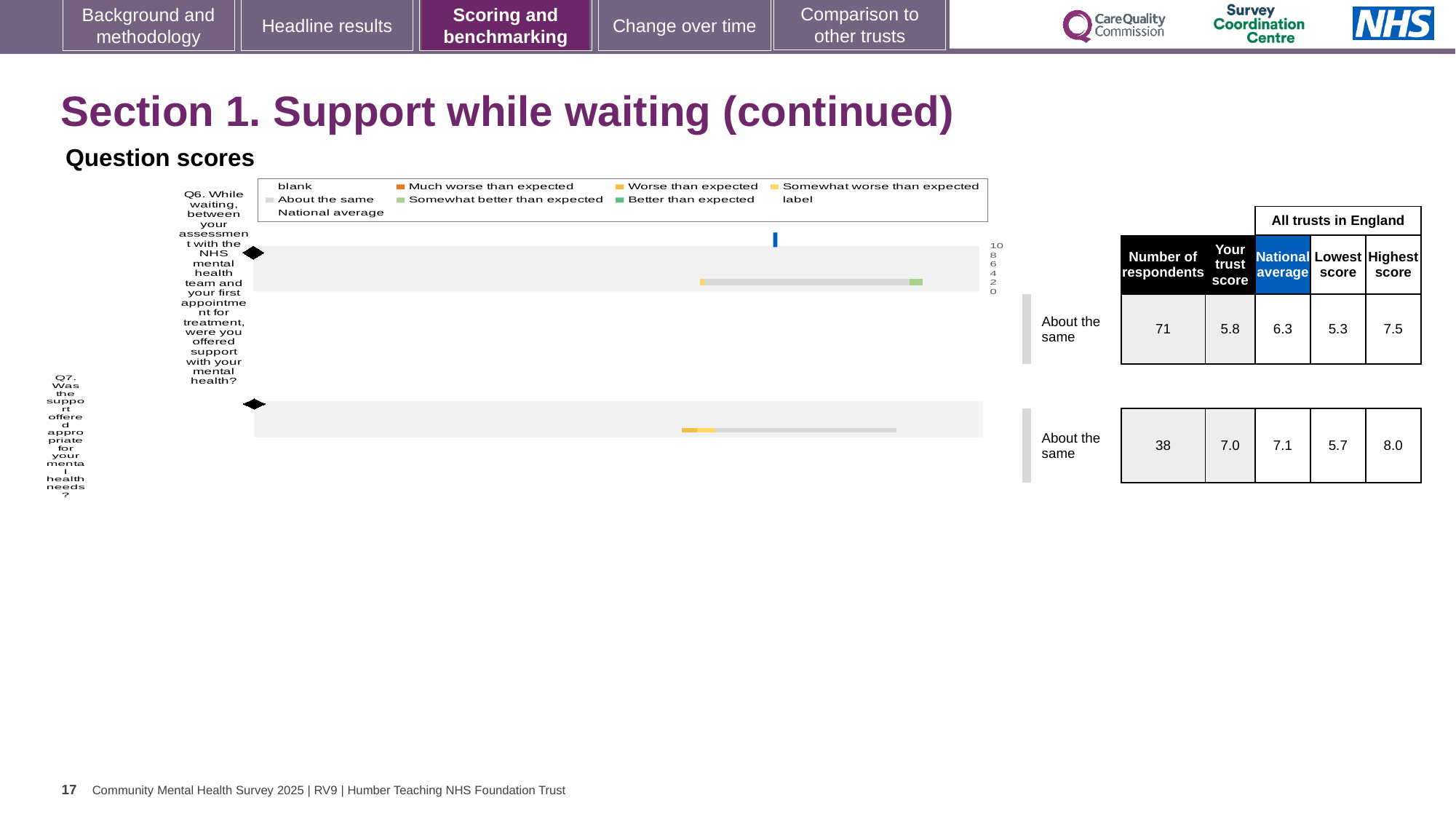
What kind of chart is used to show the question scores? bar chart How many questions (bars) are plotted in the Question scores chart? 2 What is the title of the chart on the slide? Question scores What is the highest score among all trusts in England for Q7? 8.0 What benchmark category is shown for Q7 in the Question scores chart? About the same How many respondents answered Q6? 71 What is the national average for Q7 in the Question scores chart? 7.1 What is the 'Your trust score' for Q6 in the Question scores chart? 5.8 Which question has the higher 'Your trust score', Q6 or Q7? Q7 Is the 'Your trust score' for Q6 greater or less than 6? less What is the difference between the national average and 'Your trust score' for Q7? 0.1 What is the difference between the highest score and the lowest score for Q6? 2.2